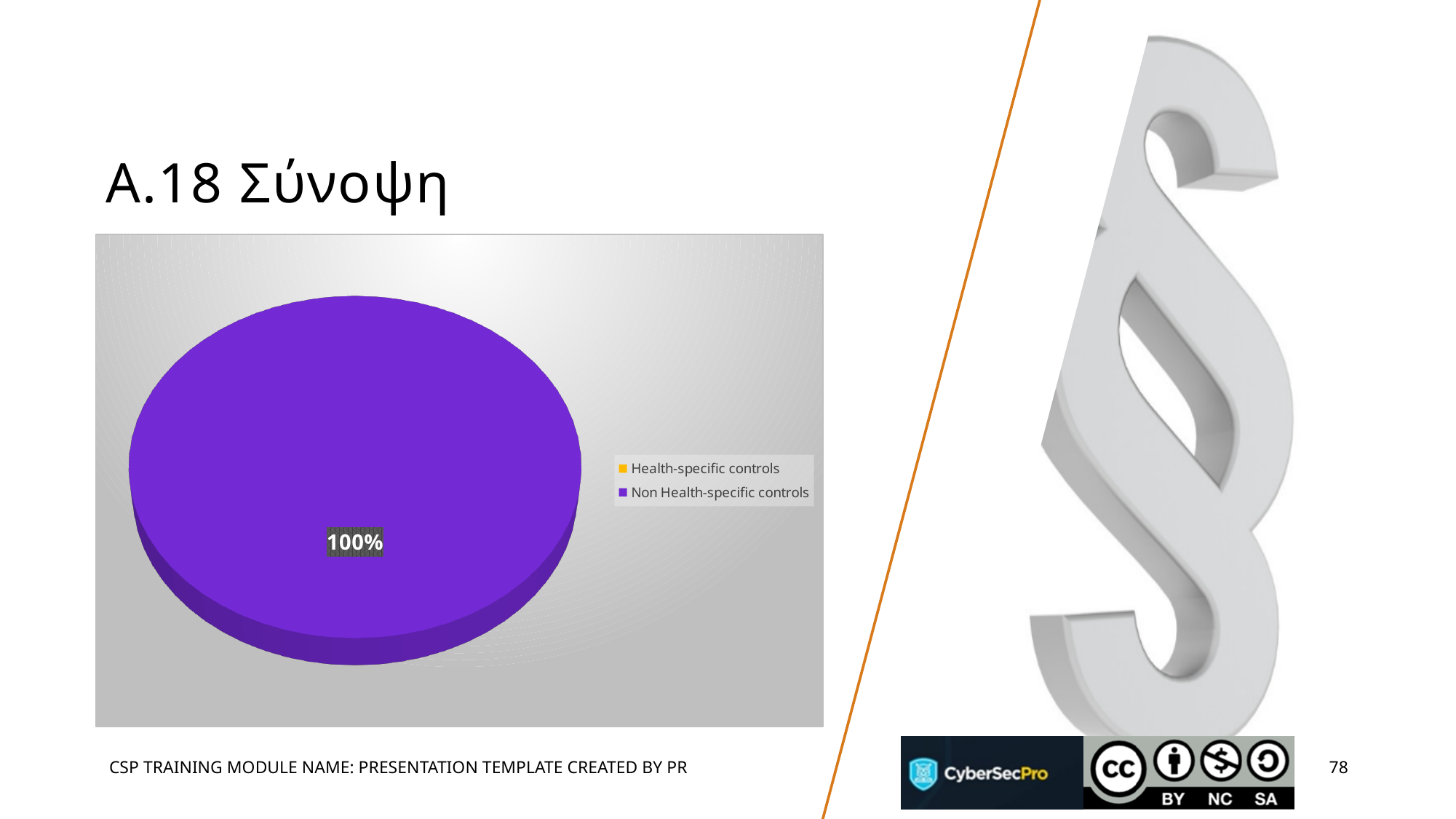
Which is larger, Health-specific controls or Non Health-specific controls? Non Health-specific controls What share of the pie does Non Health-specific controls take? 100% Which category does the 100% data label belong to? Non Health-specific controls Which category has the largest share of the pie? Non Health-specific controls What colour is the Non Health-specific controls slice? Purple What kind of chart is shown on the slide? Pie chart How many entries does the legend list? 2 What colour does the legend use for Health-specific controls? Yellow